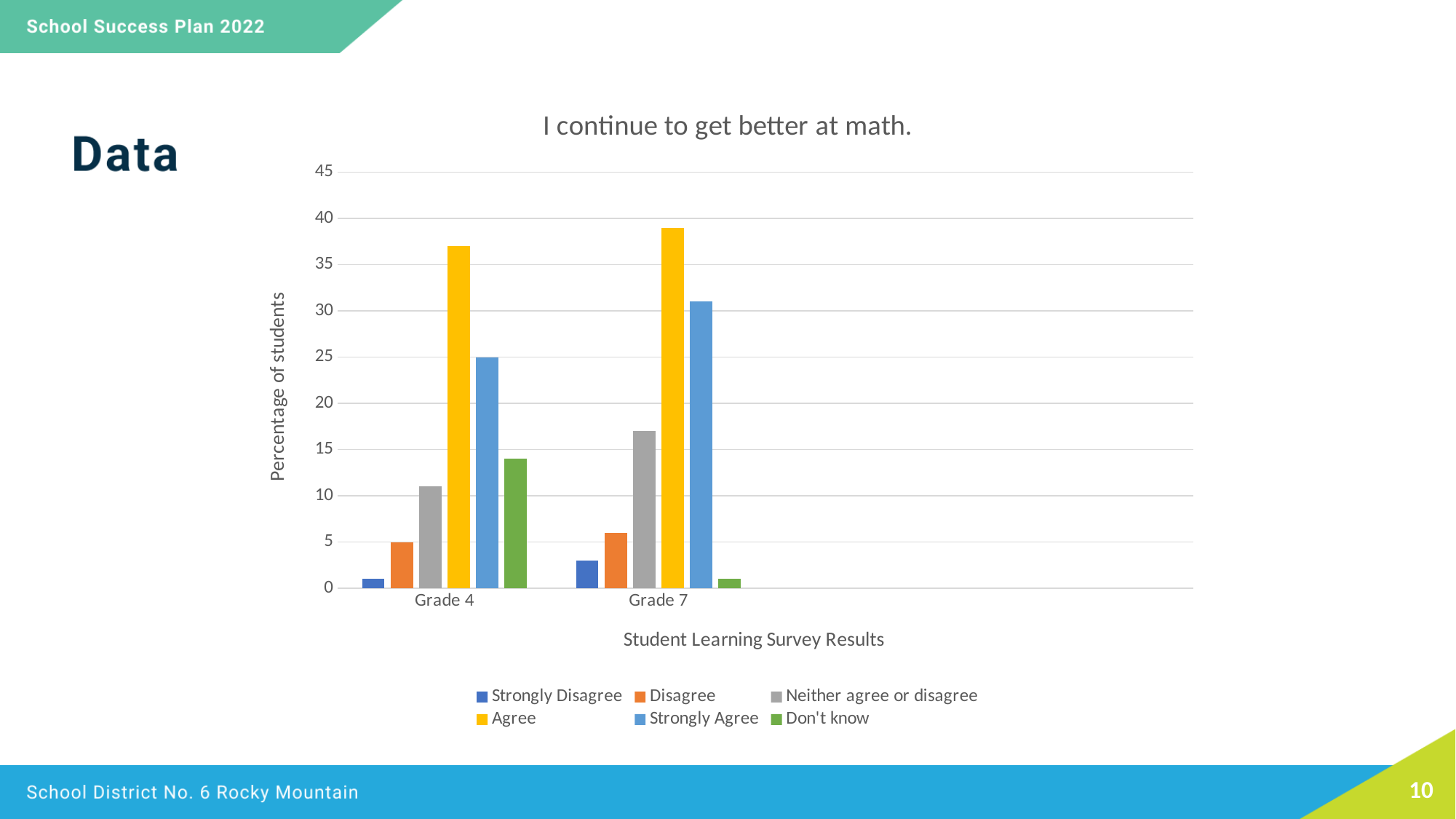
What is the title of the chart? I continue to get better at math. How many series does the legend list? 6 How many grade categories are shown on the x axis? 2 What kind of chart is shown on the slide? bar chart Which response has the lowest value for Grade 4? Strongly Disagree Which response has the highest value for Grade 7? Agree Is the value for Agree in Grade 4 greater or less than 35? greater Is the value for Neither agree or disagree in Grade 7 greater or less than 15? greater Which is larger, Strongly Agree for Grade 4 or Strongly Agree for Grade 7? Grade 7 What is the value for Strongly Agree in Grade 4? 25 What is the value for Disagree in Grade 4? 5 Which is larger, Don't know for Grade 4 or Don't know for Grade 7? Grade 4